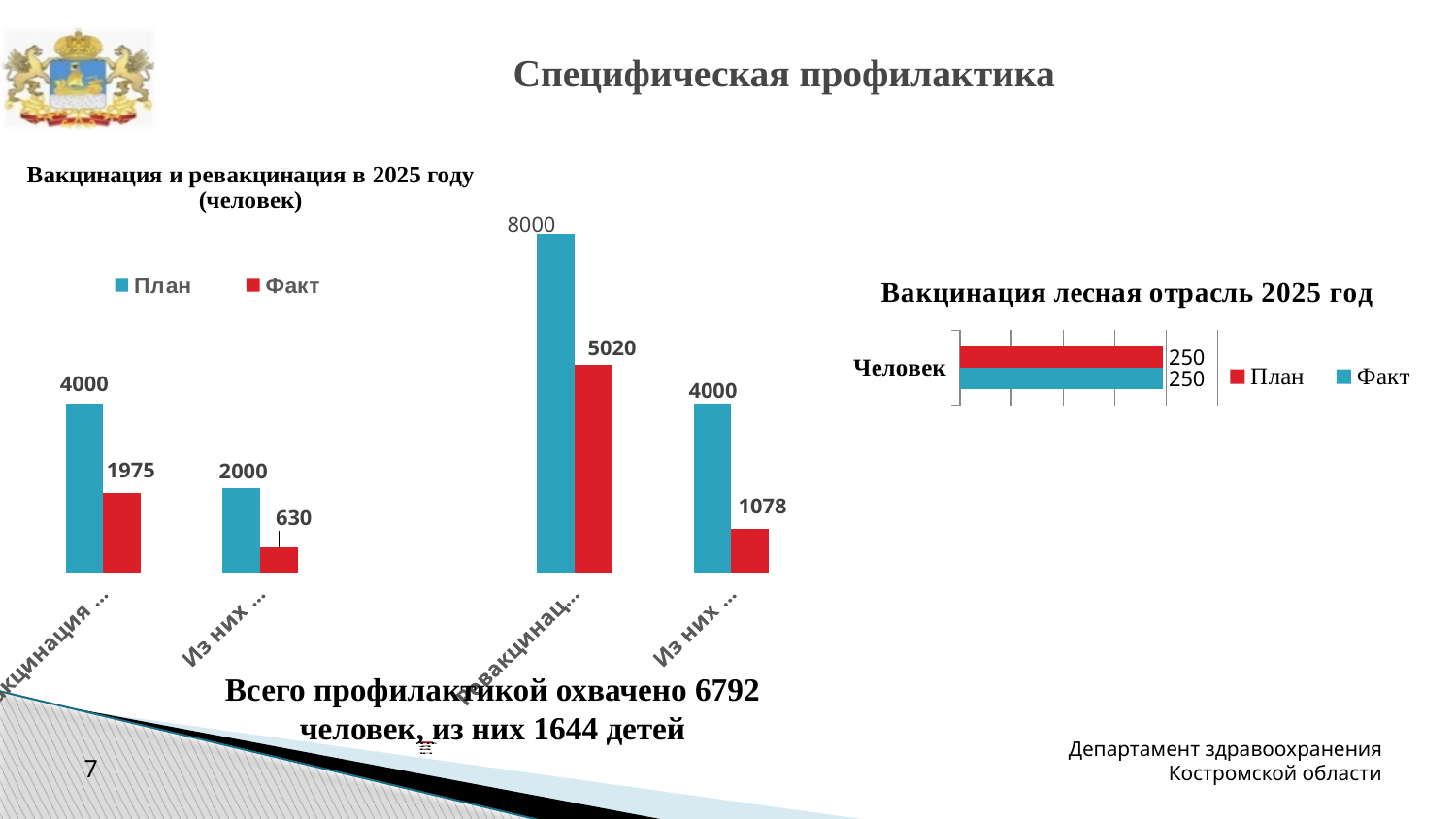
In the chart titled 'Вакцинация и ревакцинация в 2025 году (человек)', which category has the highest План value? The third category In the chart titled 'Вакцинация и ревакцинация в 2025 году (человек)', what is the difference between План and Факт for the second category? 1370 What type of chart is the chart titled 'Вакцинация лесная отрасль 2025 год'? Bar chart How many series does the legend list in the chart titled 'Вакцинация лесная отрасль 2025 год'? 2 How many categories are shown in the chart titled 'Вакцинация и ревакцинация в 2025 году (человек)'? 4 In the chart titled 'Вакцинация и ревакцинация в 2025 году (человек)', what is the Факт value for the first category? 1975 In the chart titled 'Вакцинация и ревакцинация в 2025 году (человек)', which category has the lowest Факт value? The second category In the chart titled 'Вакцинация и ревакцинация в 2025 году (человек)', what is the Факт value for the third category? 5020 In the chart titled 'Вакцинация и ревакцинация в 2025 году (человек)', which is larger: the Факт value for the first category or the Факт value for the fourth category? The Факт value for the first category In the chart titled 'Вакцинация лесная отрасль 2025 год', what is the Факт value for Человек? 250 In the chart titled 'Вакцинация и ревакцинация в 2025 году (человек)', what is the План value for the third category? 8000 In the chart titled 'Вакцинация и ревакцинация в 2025 году (человек)', what is the Факт value for the fourth category? 1078